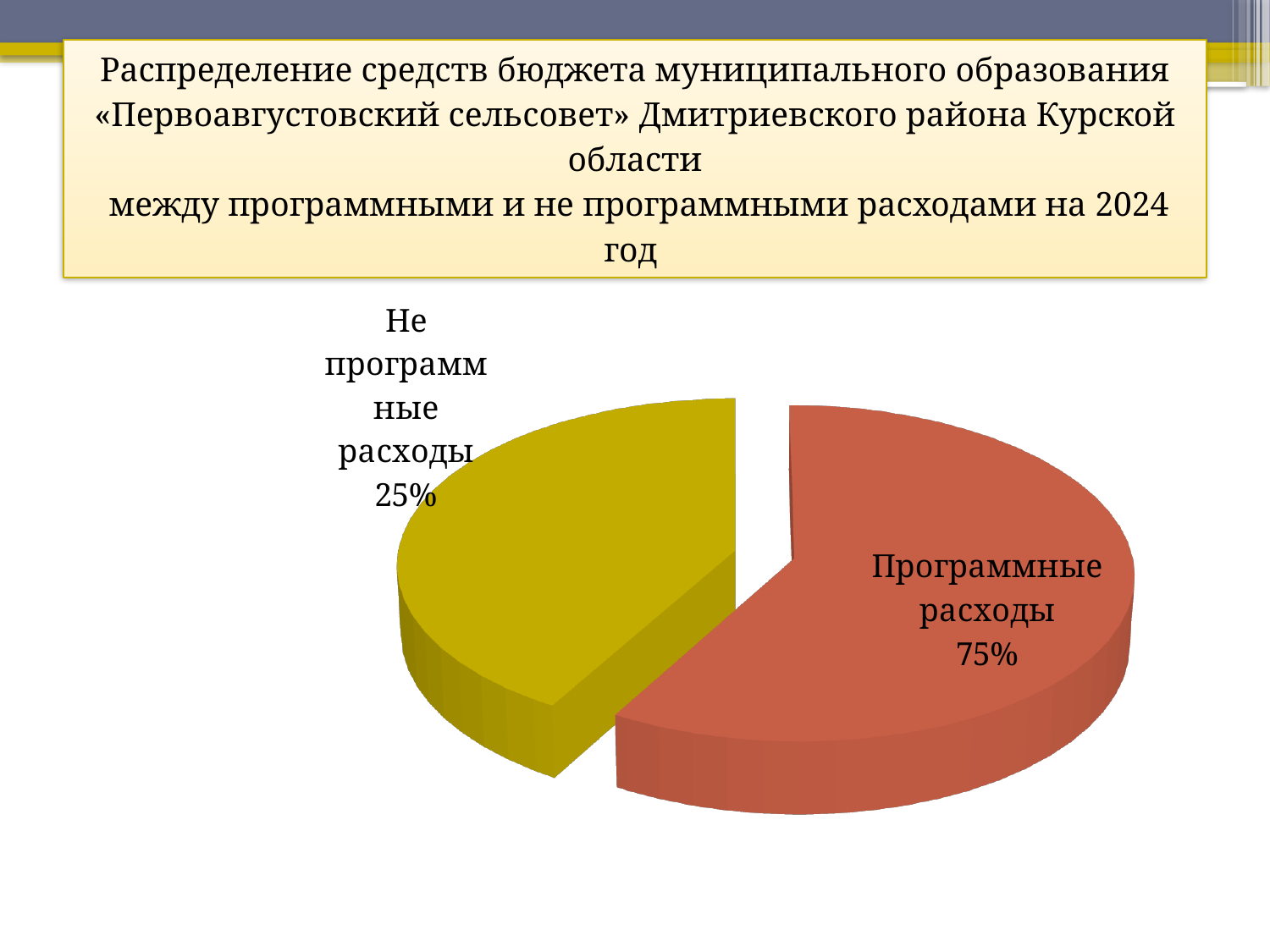
Is the share for Программные расходы greater or less than 50%? greater What share of the budget goes to Не программные расходы? 25% Which is larger: the share for Программные расходы or for Не программные расходы? Программные расходы Which category has the largest share of the pie? Программные расходы What colour is the slice for Не программные расходы? Yellow What colour is the slice for Программные расходы? Red What share of the pie does the Не программные расходы slice represent? 25% How many slices does the pie chart have? 2 Which category has the smallest share of the pie? Не программные расходы What share of the budget goes to Программные расходы? 75% What is the difference in percentage points between Программные расходы and Не программные расходы? 50 What kind of chart is shown on the slide? Pie chart